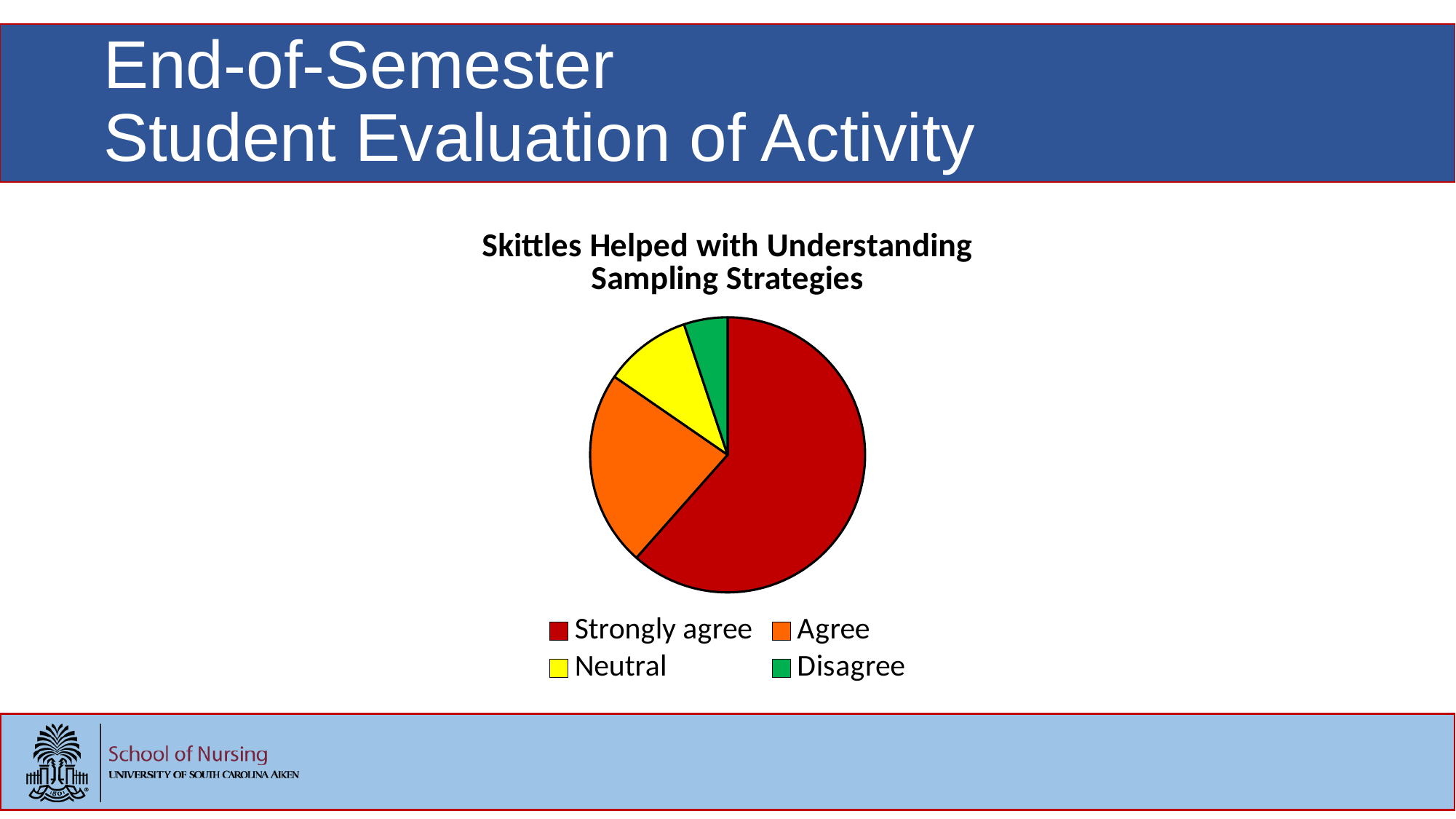
How many categories does the pie chart have? 4 What colour is the Neutral slice in the pie chart? Yellow Which slice is larger, Agree or Neutral? Agree Which slice is larger, Strongly agree or Agree? Strongly agree How many entries does the legend list? 4 Which slice is larger, Neutral or Disagree? Neutral What kind of chart is shown on the slide? Pie chart Which category has the smallest slice of the pie? Disagree Which category has the largest slice of the pie? Strongly agree What is the title of the chart? Skittles Helped with Understanding Sampling Strategies